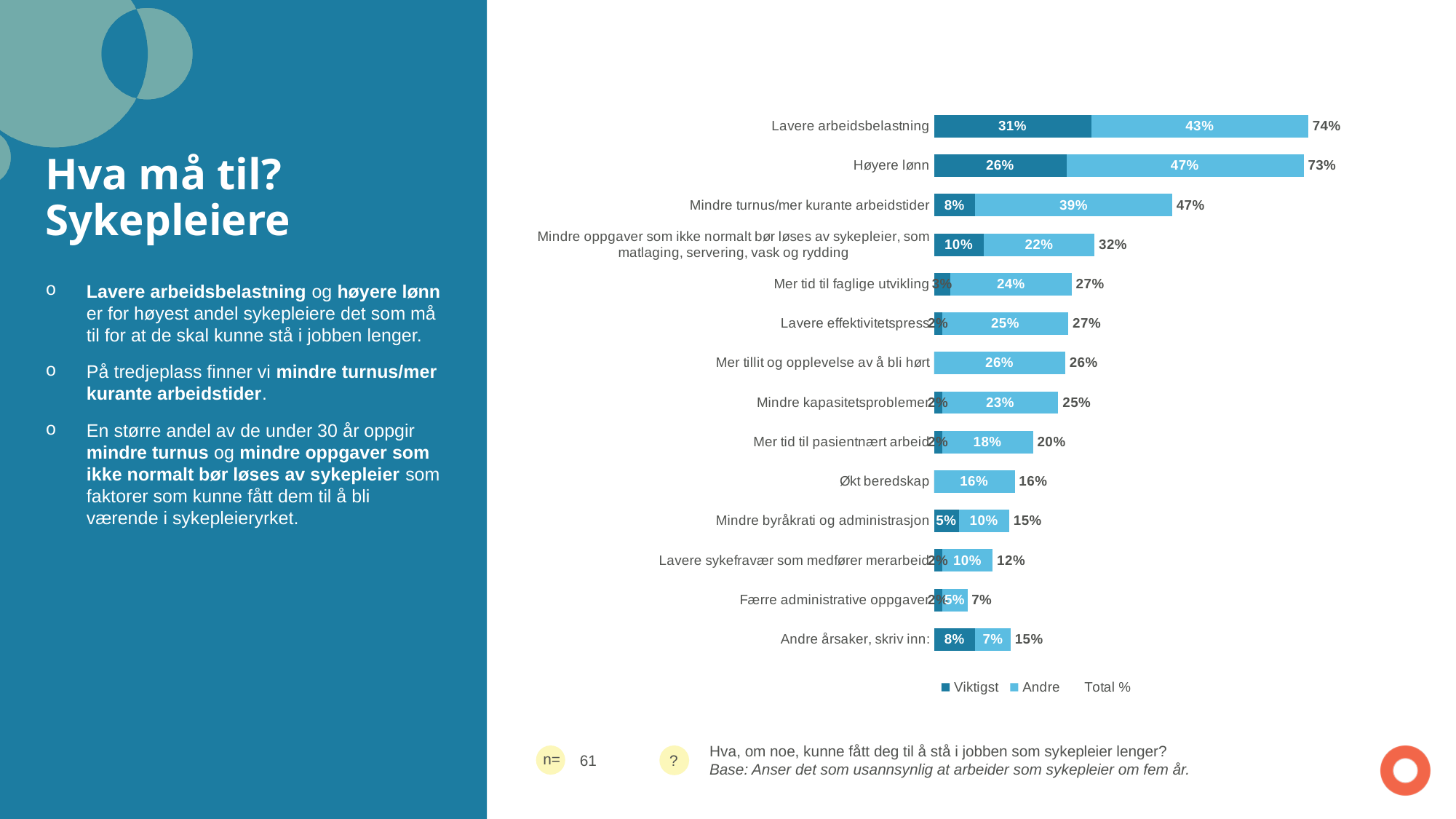
How many entries does the chart legend list? 3 What is the sample size (n) shown on the slide? 61 What is the "Andre" value for "Mindre turnus/mer kurante arbeidstider"? 39% What is the difference between the total for "Lavere arbeidsbelastning" and the total for "Høyere lønn"? 1% Which category has the lowest total percentage? Færre administrative oppgaver Which category has the highest total percentage? Lavere arbeidsbelastning What is the total percentage shown for "Lavere arbeidsbelastning"? 74% Which has a larger "Andre" value: "Høyere lønn" or "Lavere arbeidsbelastning"? Høyere lønn What is the "Viktigst" value for "Høyere lønn"? 26% What type of chart is shown on the slide? Stacked bar chart How many categories are shown in the chart? 14 What is the total of the stacked bar for "Mindre byråkrati og administrasjon"? 15%